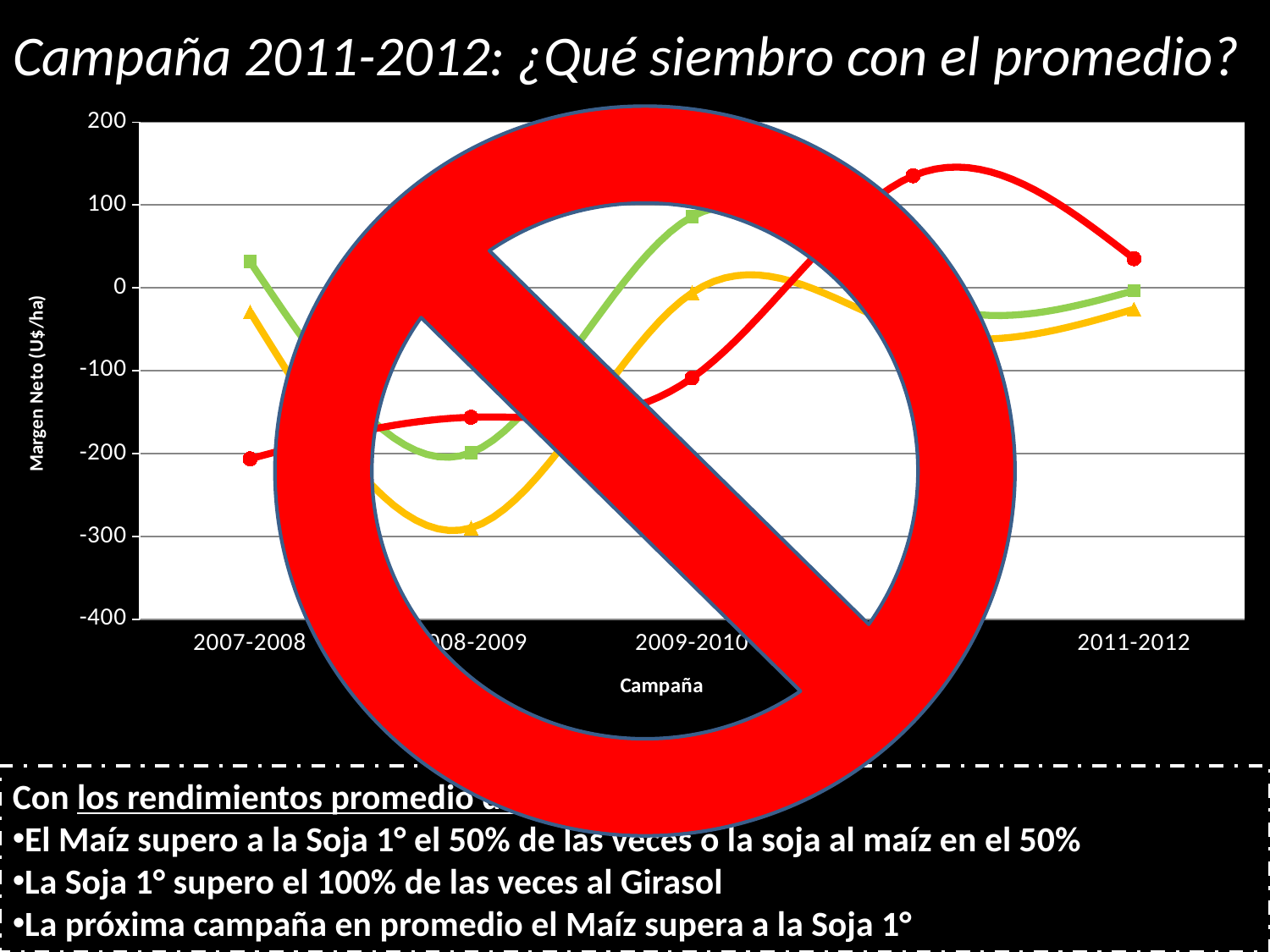
Is the value of the green line for 2009-2010 greater or less than 0? greater Is the value of the red line for 2009-2010 greater or less than 0? less What is the title of the vertical axis of the chart? Margen Neto (U$/ha) Does the red line rise or fall overall from 2007-2008 to 2011-2012? rise At 2007-2008, which line has the higher value, the green line or the red line? the green line What is the title of the horizontal axis of the chart? Campaña At 2011-2012, which line has the higher value, the red line or the yellow line? the red line Is the value of the yellow line for 2008-2009 greater or less than -200? less What kind of chart is shown on the slide? line chart